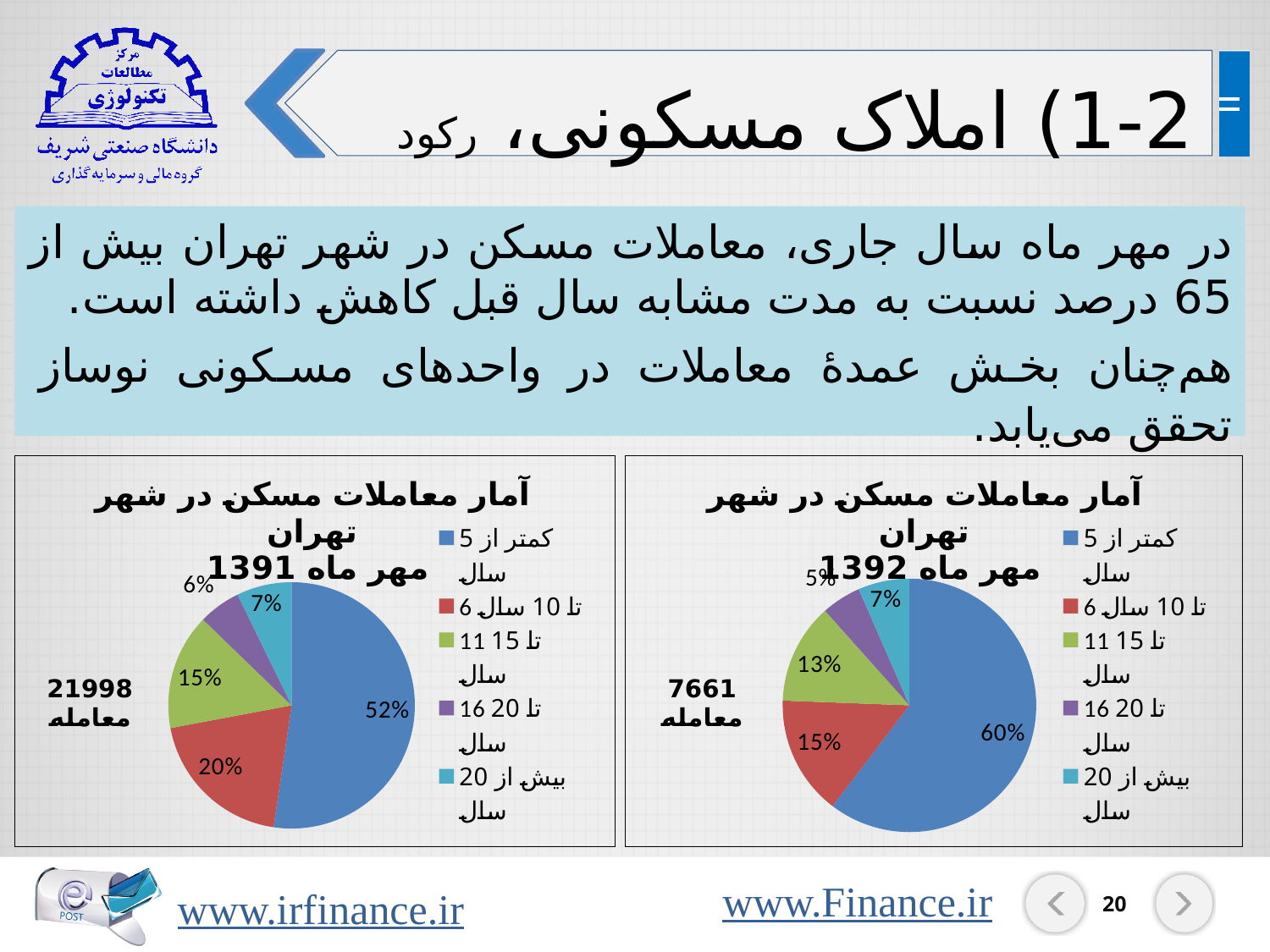
How many categories does the legend of the right-hand pie chart list? 5 What type of chart is used on this slide? Pie chart What total number of transactions is shown next to the left-hand pie chart (Mehr 1391)? 21998 معامله What is the difference between the share of units less than 5 years old in the right-hand chart (Mehr 1392) and in the left-hand chart (Mehr 1391)? 8% What total number of transactions is shown next to the right-hand pie chart (Mehr 1392)? 7661 معامله In the left-hand pie chart (Mehr 1391), what share of transactions is for units less than 5 years old (کمتر از 5 سال)? 52% In the left-hand pie chart (Mehr 1391), what share is shown for the 6 to 10 years category (6 تا 10 سال)? 20% In the right-hand pie chart (Mehr 1392), what share is shown for the 11 to 15 years category (11 تا 15 سال)? 13% In the right-hand pie chart (Mehr 1392), which category has the smallest share? 16 تا 20 سال In the right-hand pie chart (Mehr 1392), what share of transactions is for units less than 5 years old (کمتر از 5 سال)? 60% In the left-hand pie chart (Mehr 1391), which category has the largest share? کمتر از 5 سال Which is larger: the 6 to 10 years share in the left-hand chart (Mehr 1391) or in the right-hand chart (Mehr 1392)? Left-hand chart (Mehr 1391), 20%